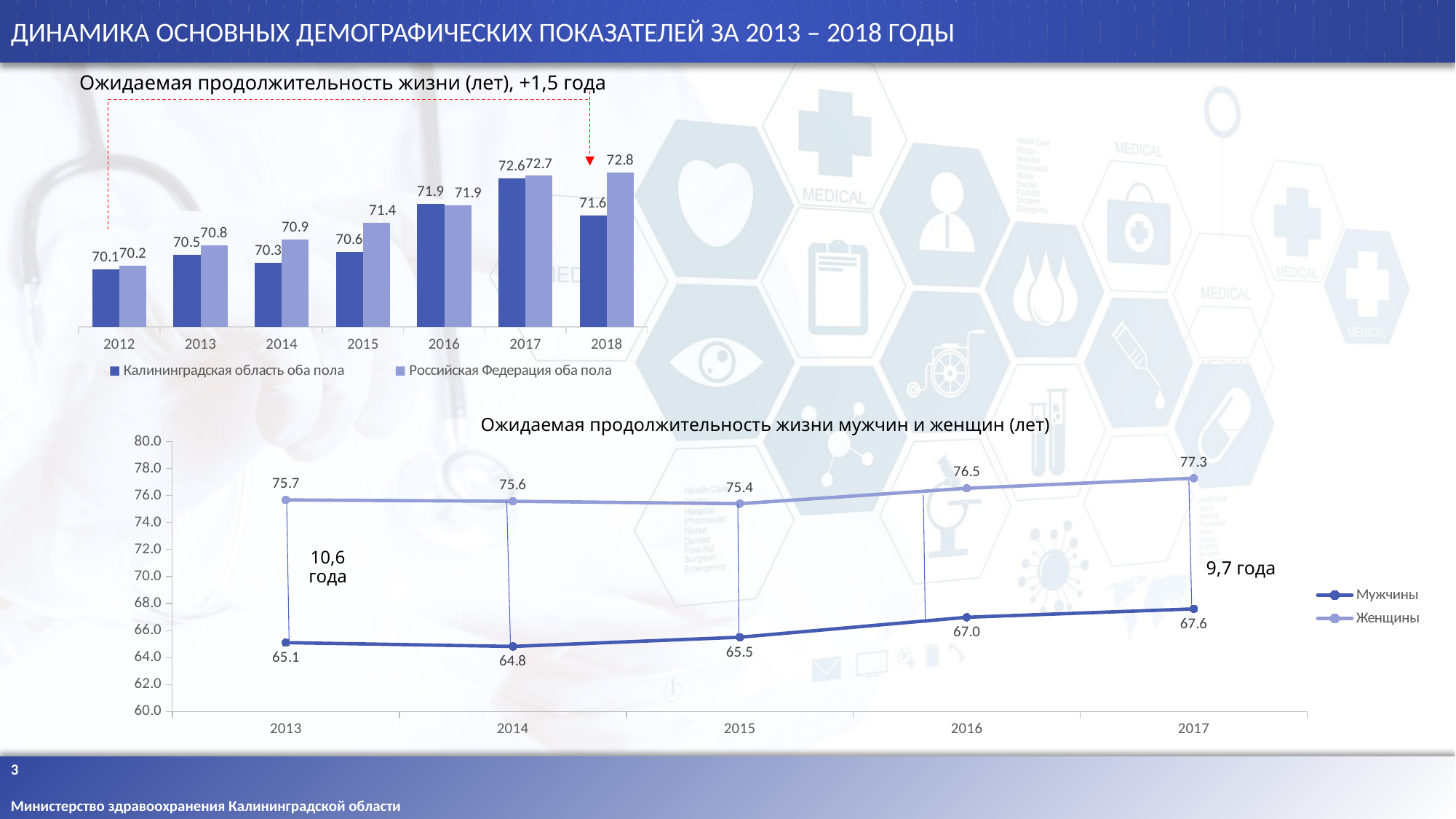
In the top bar chart, what is the value for Российская Федерация оба пола in 2018? 72.8 In the top bar chart, which year has the lowest value for Российская Федерация оба пола? 2012 In the bottom line chart, what is the difference between Женщины and Мужчины in 2017? 9.7 In the top bar chart, how many series does the legend list? 2 In the bottom line chart, what is the value for Женщины in 2016? 76.5 What kind of chart is the bottom chart (Ожидаемая продолжительность жизни мужчин и женщин (лет))? Line chart In the bottom line chart, what is the value for Мужчины in 2014? 64.8 In the bottom line chart, which year has the lowest value for Мужчины? 2014 In the top bar chart (Ожидаемая продолжительность жизни (лет), +1,5 года), what is the value for Калининградская область оба пола in 2017? 72.6 In the top bar chart, what is the difference between Российская Федерация оба пола and Калининградская область оба пола in 2018? 1.2 In the top bar chart, which year has the highest value for Калининградская область оба пола? 2017 In the top bar chart, how many years are shown on the x axis? 7